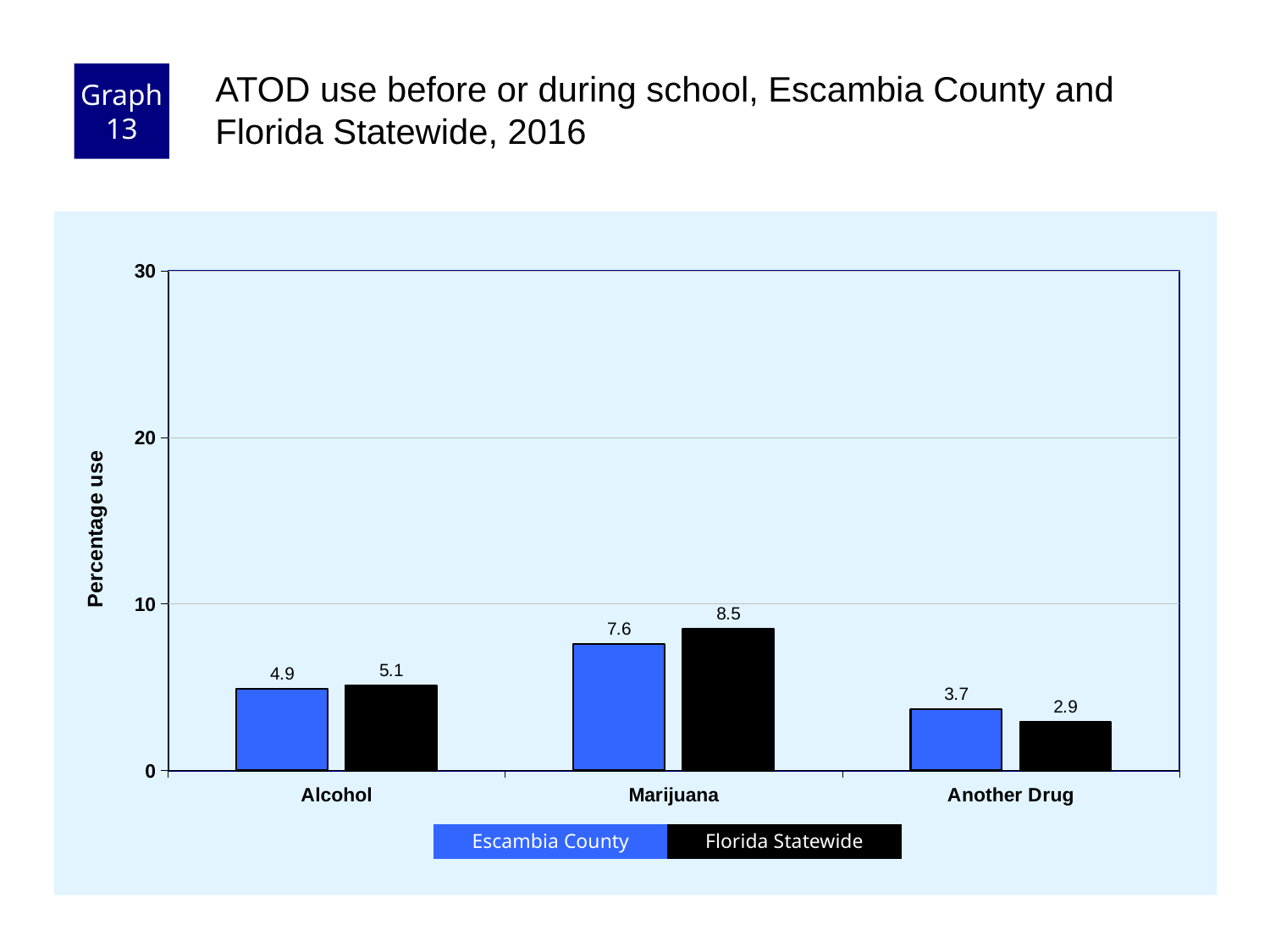
How many series does the legend list? 2 Is the Florida Statewide value for Marijuana greater or less than 10? less What kind of chart is shown on the slide? bar chart What is the Florida Statewide value for Marijuana? 8.5 For Another Drug, which is larger: Escambia County or Florida Statewide? Escambia County How many categories are shown on the x axis? 3 What is the Florida Statewide value for Another Drug? 2.9 Which category has the lowest Florida Statewide value? Another Drug Which category has the highest Escambia County value? Marijuana What is the difference between the Florida Statewide and Escambia County values for Marijuana? 0.9 What is the label of the y axis? Percentage use What is the Escambia County value for Alcohol? 4.9